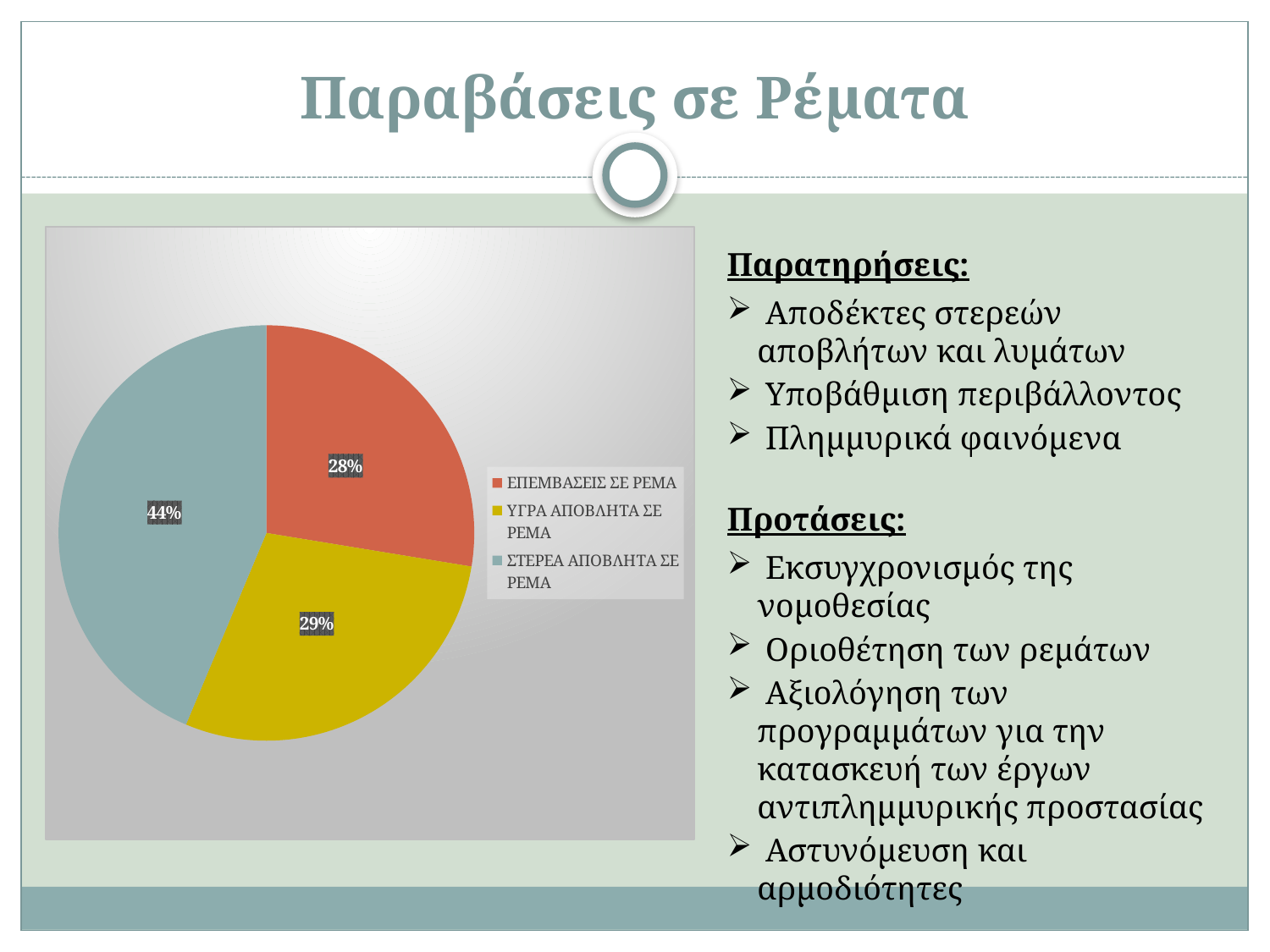
How many entries does the legend of the pie chart list? 3 What is the difference in percentage points between ΣΤΕΡΕΑ ΑΠΟΒΛΗΤΑ ΣΕ ΡΕΜΑ and ΕΠΕΜΒΑΣΕΙΣ ΣΕ ΡΕΜΑ? 16 Which category has the largest share of the pie? ΣΤΕΡΕΑ ΑΠΟΒΛΗΤΑ ΣΕ ΡΕΜΑ What percentage of the pie is ΣΤΕΡΕΑ ΑΠΟΒΛΗΤΑ ΣΕ ΡΕΜΑ? 44% What is the difference in percentage points between ΥΓΡΑ ΑΠΟΒΛΗΤΑ ΣΕ ΡΕΜΑ and ΕΠΕΜΒΑΣΕΙΣ ΣΕ ΡΕΜΑ? 1 Which is larger, the share for ΣΤΕΡΕΑ ΑΠΟΒΛΗΤΑ ΣΕ ΡΕΜΑ or the share for ΥΓΡΑ ΑΠΟΒΛΗΤΑ ΣΕ ΡΕΜΑ? ΣΤΕΡΕΑ ΑΠΟΒΛΗΤΑ ΣΕ ΡΕΜΑ What colour is the slice for ΥΓΡΑ ΑΠΟΒΛΗΤΑ ΣΕ ΡΕΜΑ? yellow What percentage of the pie is ΕΠΕΜΒΑΣΕΙΣ ΣΕ ΡΕΜΑ? 28% What percentage of the pie is ΥΓΡΑ ΑΠΟΒΛΗΤΑ ΣΕ ΡΕΜΑ? 29% Which category has the smallest share of the pie? ΕΠΕΜΒΑΣΕΙΣ ΣΕ ΡΕΜΑ How many categories does the pie chart have? 3 What kind of chart is shown on the slide? pie chart